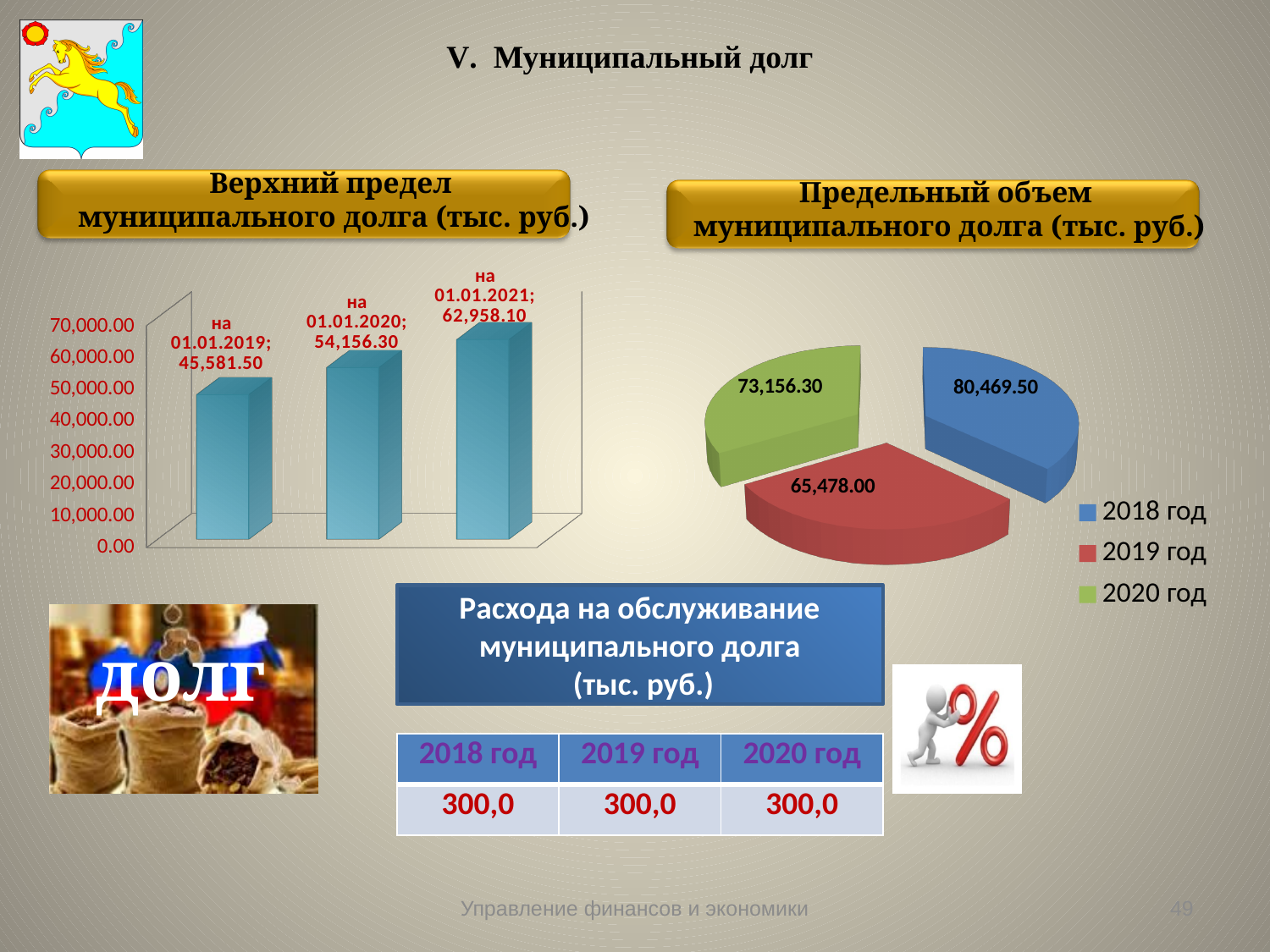
In the bar chart 'Верхний предел муниципального долга (тыс. руб.)', how many bars are plotted? 3 In the bar chart 'Верхний предел муниципального долга (тыс. руб.)', which date has the highest value? на 01.01.2021 In the bar chart 'Верхний предел муниципального долга (тыс. руб.)', what is the value for на 01.01.2019? 45,581.50 In the bar chart 'Верхний предел муниципального долга (тыс. руб.)', what is the value for на 01.01.2021? 62,958.10 In the bar chart 'Верхний предел муниципального долга (тыс. руб.)', do the values rise or fall from left to right? rise In the pie chart 'Предельный объем муниципального долга (тыс. руб.)', what is the difference between the values for 2018 год and 2020 год? 7,313.20 In the pie chart 'Предельный объем муниципального долга (тыс. руб.)', what is the value for 2019 год? 65,478.00 In the pie chart 'Предельный объем муниципального долга (тыс. руб.)', which year has the smallest value? 2019 год In the pie chart 'Предельный объем муниципального долга (тыс. руб.)', which colour represents 2020 год? green What kind of chart is 'Верхний предел муниципального долга (тыс. руб.)'? bar chart In the pie chart 'Предельный объем муниципального долга (тыс. руб.)', which year has the largest value? 2018 год In the bar chart 'Верхний предел муниципального долга (тыс. руб.)', what is the difference between the values for на 01.01.2021 and на 01.01.2019? 17,376.60